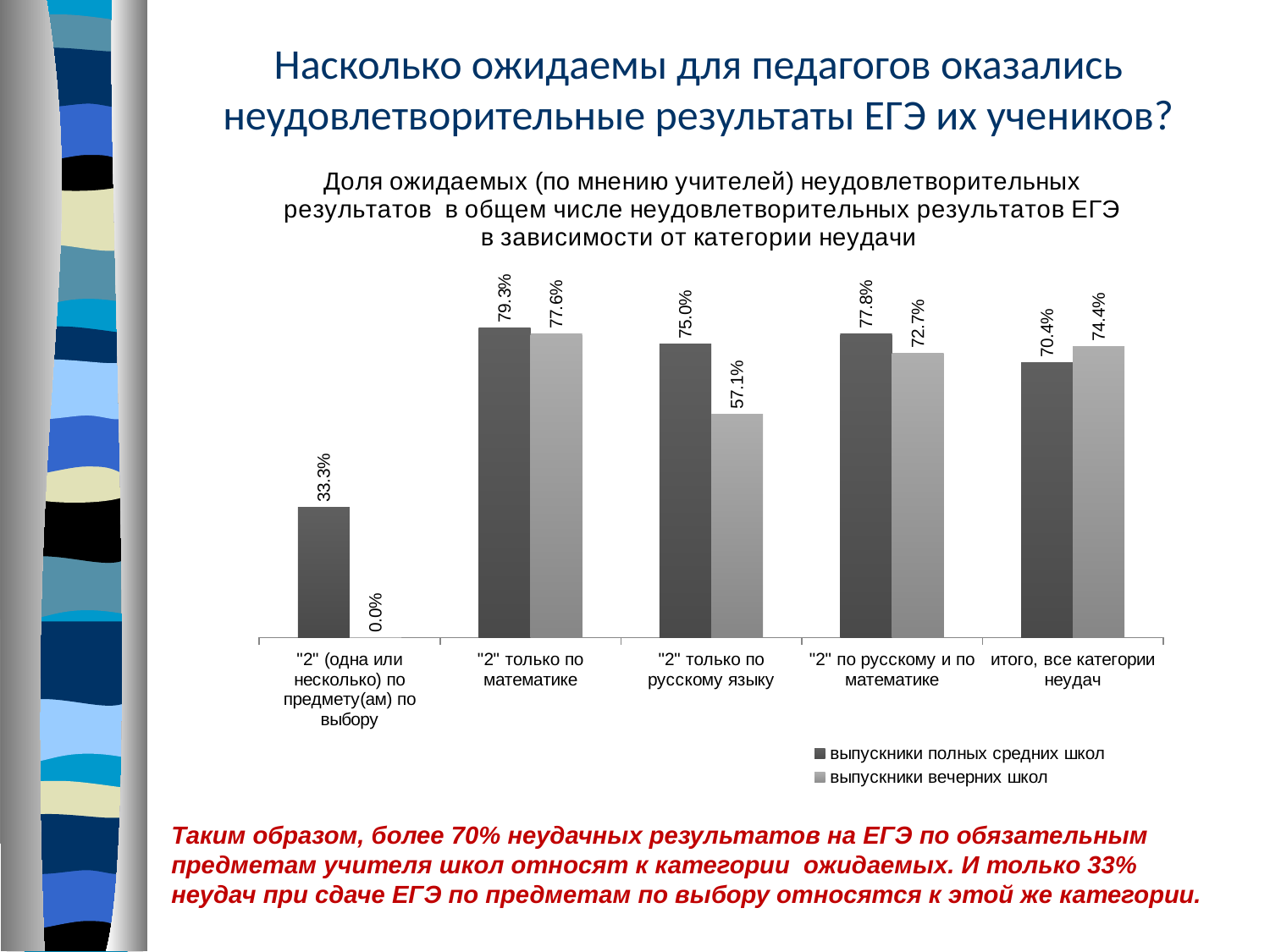
What is the value for "выпускники полных средних школ" in the category "2" только по математике? 79.3% Which category has the lowest value for "выпускники вечерних школ"? "2" (одна или несколько) по предмету(ам) по выбору Which category has the highest value for "выпускники полных средних школ"? "2" только по математике What is the value for "выпускники вечерних школ" in the category "2" по русскому и по математике? 72.7% What is the difference between "выпускники полных средних школ" and "выпускники вечерних школ" in the category "2" только по русскому языку? 17.9% How many series does the chart legend list? 2 What is the value for "выпускники вечерних школ" in the category "2" (одна или несколько) по предмету(ам) по выбору? 0.0% In the category "итого, все категории неудач", which series has the larger value: "выпускники полных средних школ" or "выпускники вечерних школ"? выпускники вечерних школ How many categories are shown on the x axis of the chart? 5 What kind of chart is shown on the slide? bar chart What is the value for "выпускники полных средних школ" in the category "итого, все категории неудач"? 70.4% What is the value for "выпускники вечерних школ" in the category "2" только по русскому языку? 57.1%